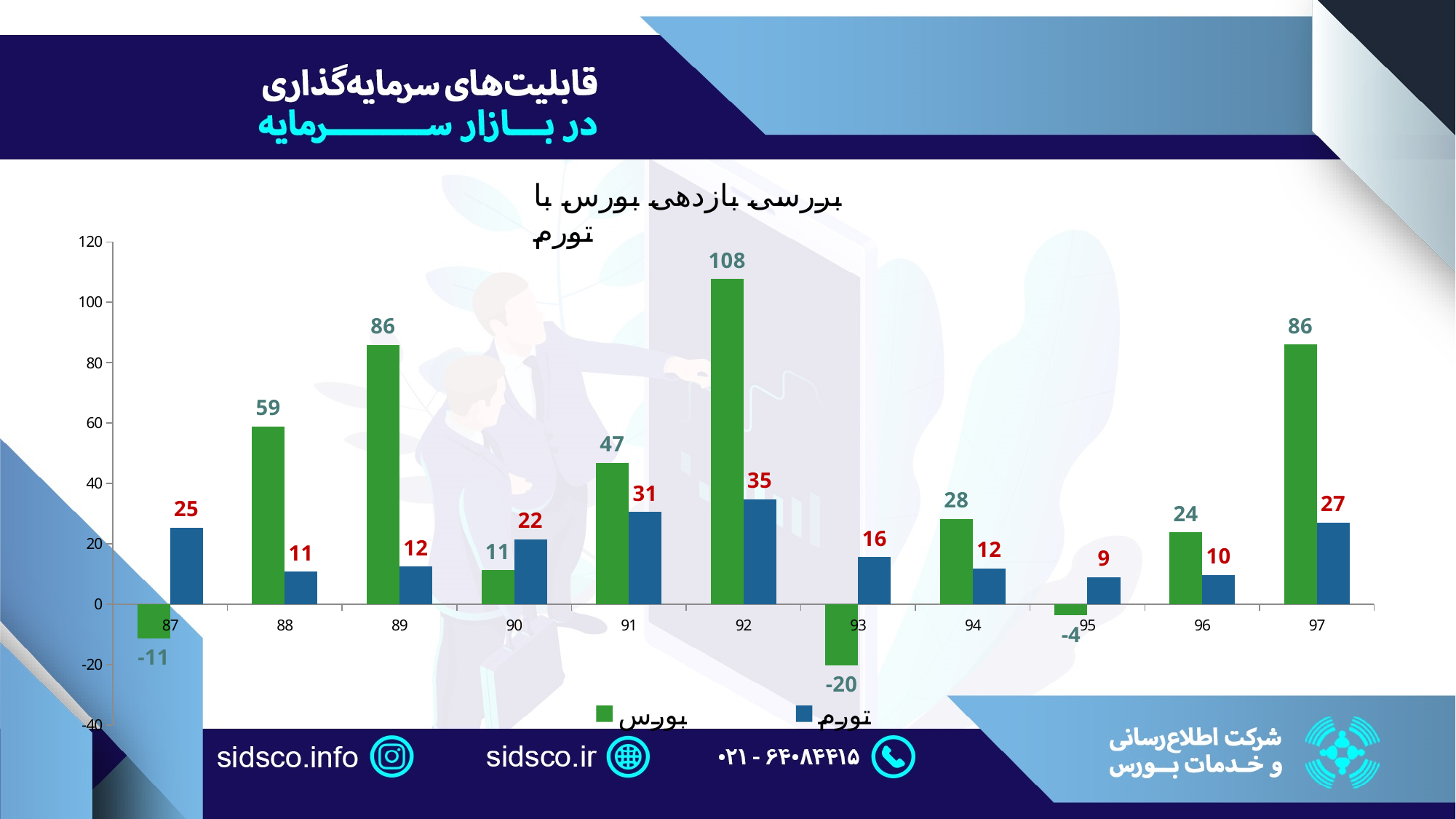
What is the difference between the بورس values for years 89 and 88? 27 What is the difference between the بورس and تورم values for year 97? 59 What is the value of بورس for year 93? -20 Which colour represents the تورم series? blue Which year has the highest بورس value? 92 Which year has the lowest تورم value? 95 Which is larger for year 90, بورس or تورم? تورم What kind of chart is shown on the slide? bar chart What is the value of بورس for year 92? 108 How many series does the legend list? 2 What is the value of تورم for year 91? 31 How many years are shown on the x axis? 11